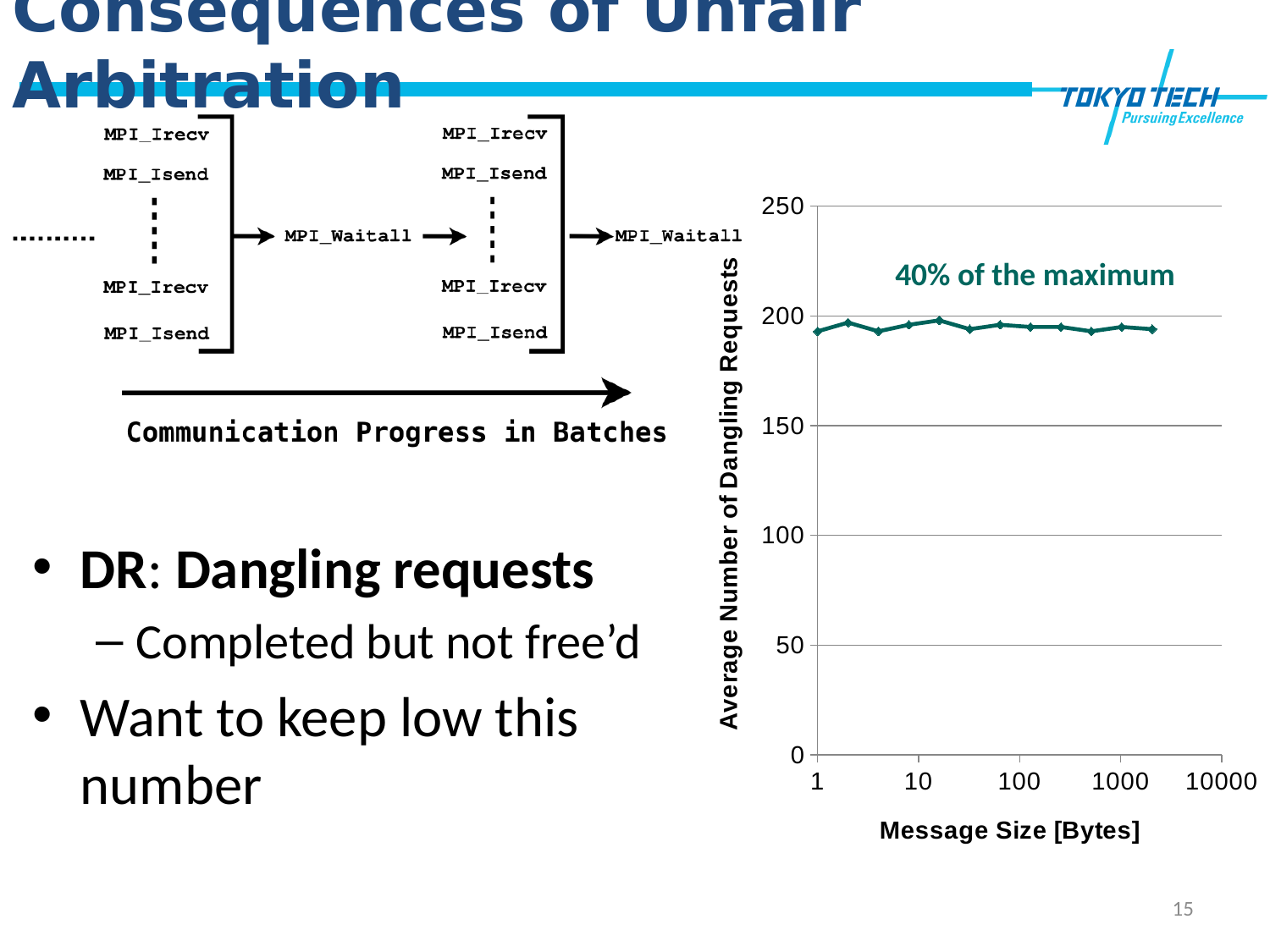
What kind of chart is shown on the right side of the slide? line chart What is the highest tick value shown on the y axis of the chart? 250 What is the label of the y axis of the chart? Average Number of Dangling Requests Do the plotted values rise, fall, or stay roughly flat as message size increases along the x axis? roughly flat Is the average number of dangling requests at message size 1000 bytes greater or less than 200? less Is the average number of dangling requests at message size 10 bytes greater or less than 100? greater What is the label of the x axis of the chart? Message Size [Bytes] Is the average number of dangling requests at message size 1 byte greater or less than 150? greater How many data points are plotted on the line in the chart? 12 How many data series are plotted in the chart? 1